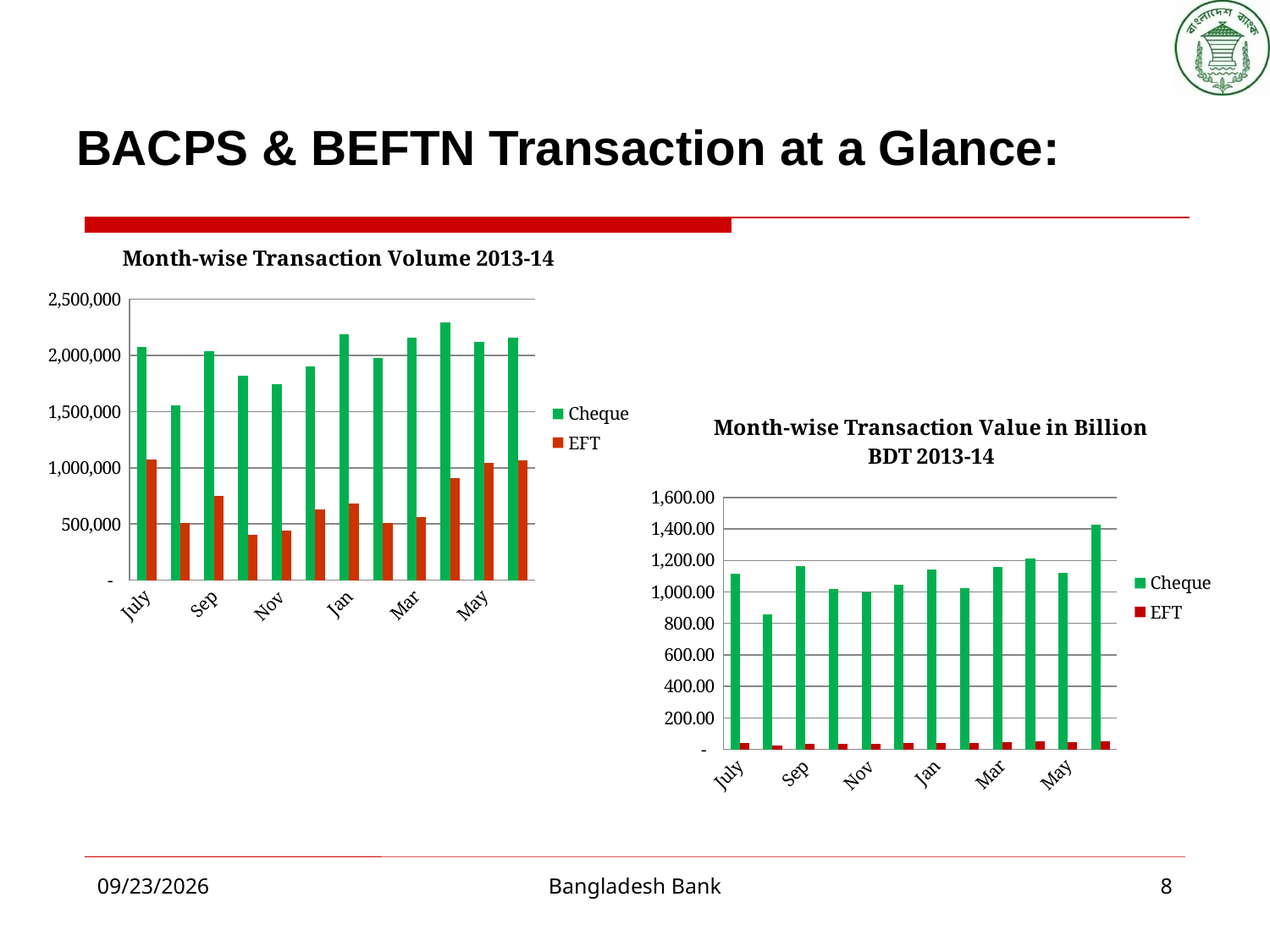
What kind of chart is the 'Month-wise Transaction Volume 2013-14' chart? bar chart How many series does the legend of the 'Month-wise Transaction Value in Billion BDT 2013-14' chart list? 2 In the 'Month-wise Transaction Volume 2013-14' chart, is the Cheque value for Nov greater or less than 2,000,000? less In the 'Month-wise Transaction Value in Billion BDT 2013-14' chart, is the EFT value for Jan greater or less than 200.00? less In the 'Month-wise Transaction Volume 2013-14' chart, is the EFT value for July greater or less than 1,000,000? greater What is the title of the chart on the right side of the slide? Month-wise Transaction Value in Billion BDT 2013-14 In the 'Month-wise Transaction Volume 2013-14' chart, which series has the higher value in Sep, Cheque or EFT? Cheque What colour are the Cheque bars in the 'Month-wise Transaction Volume 2013-14' chart? green In the 'Month-wise Transaction Value in Billion BDT 2013-14' chart, which series has the lower values throughout, Cheque or EFT? EFT